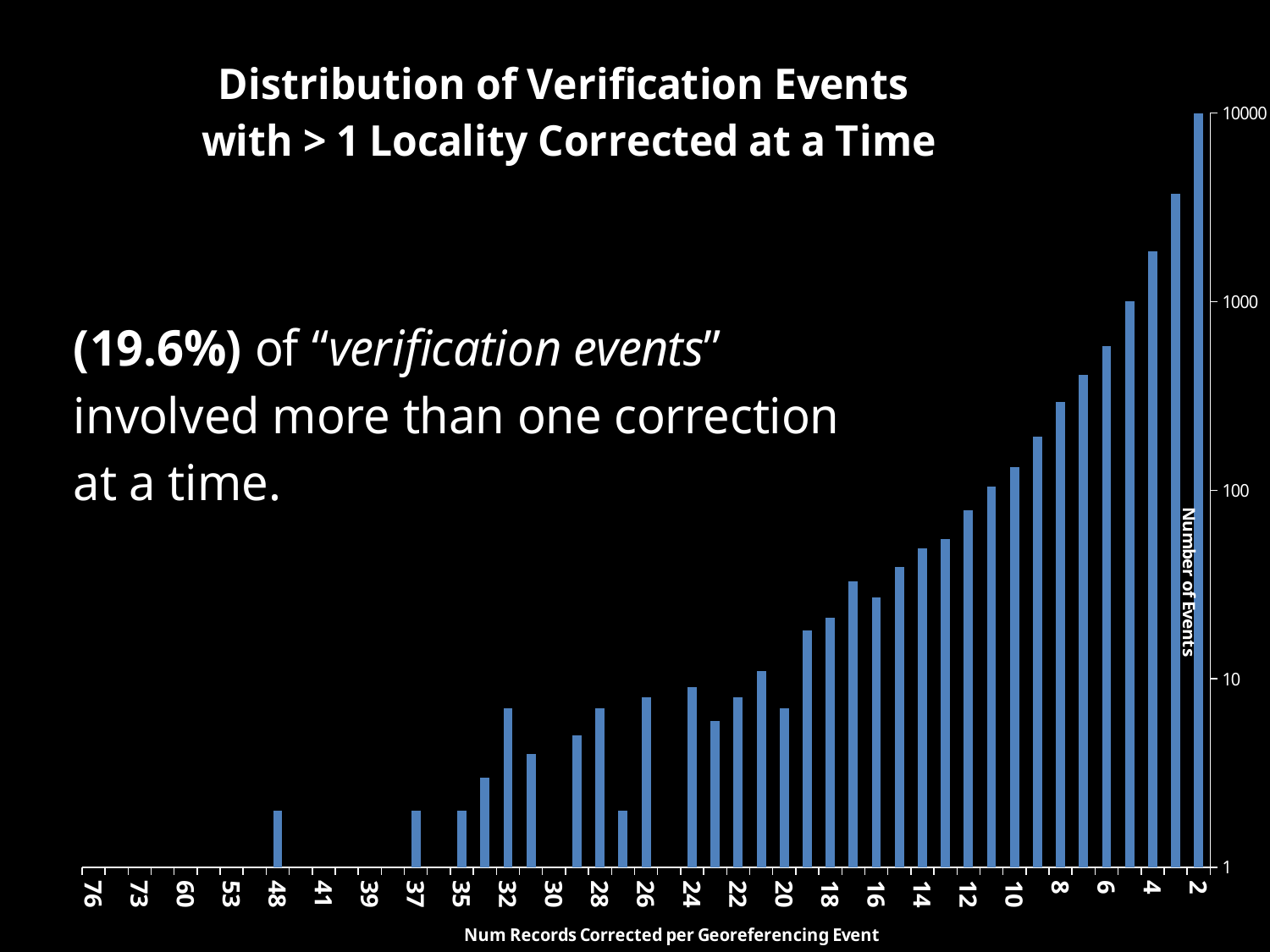
Is the number of events for 2 records corrected greater or less than 1000? greater Is the number of events for 48 records corrected greater or less than 10? less What is the title of the chart? Distribution of Verification Events with > 1 Locality Corrected at a Time Do the bars generally rise or fall moving from left to right along the x axis? rise Is the number of events for 8 records corrected greater or less than 100? greater What kind of chart is shown on the slide? bar chart Which has more events: 2 records corrected or 4 records corrected? 2 Which has more events: 48 records corrected or 24 records corrected? 24 Which x-axis category has the highest number of events? 2 What is the label of the x axis? Num Records Corrected per Georeferencing Event